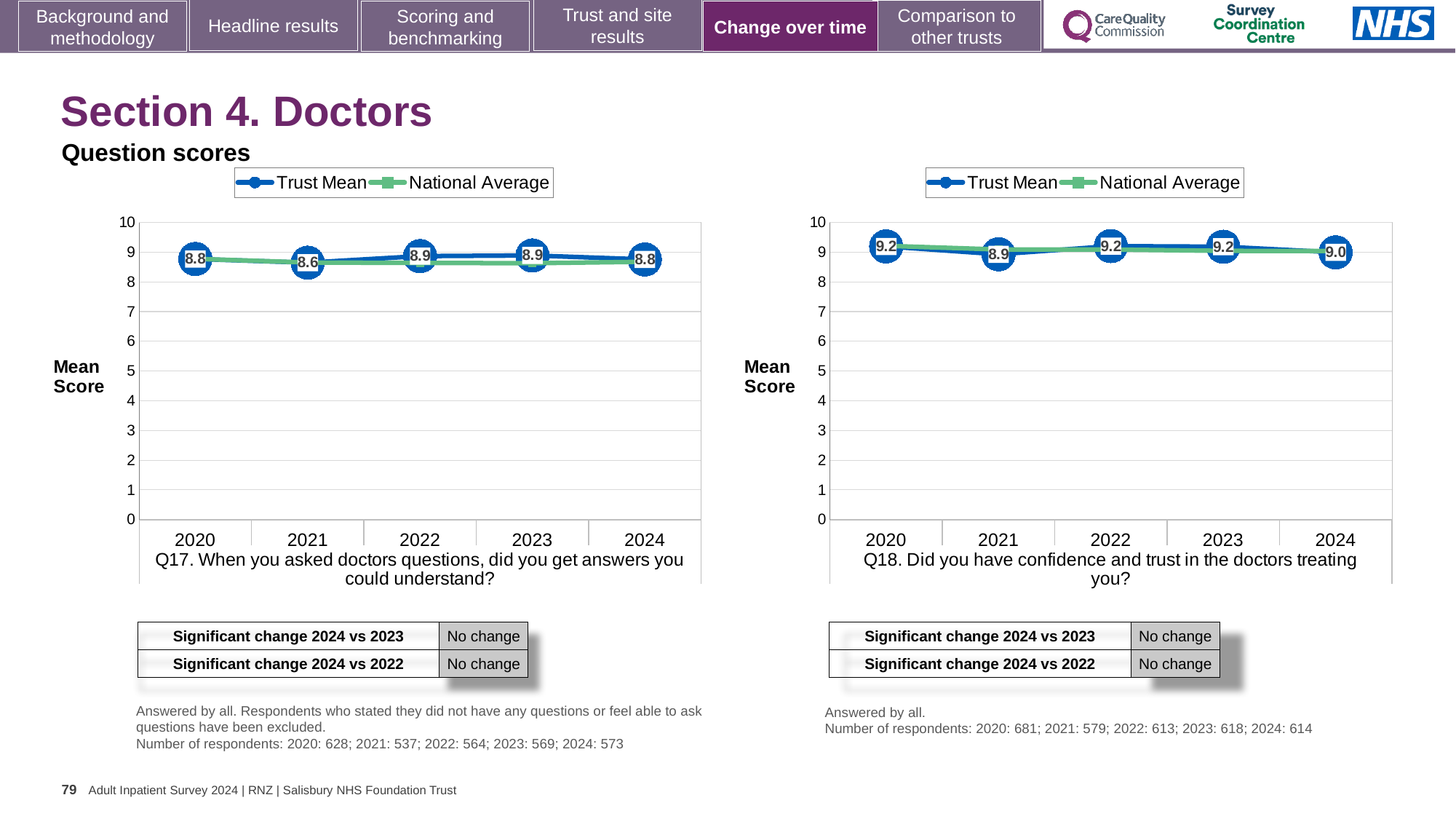
How many years are plotted on the x axis of the Q18 chart (right)? 5 In the Q17 chart (left), what is the difference between the Trust Mean scores for 2022 and 2021? 0.3 In the Q17 chart (left), what is the Trust Mean score for 2021? 8.6 In the Q17 chart (left), is the National Average value for 2024 greater or less than 8? greater In the Q18 chart (right), what is the Trust Mean score for 2024? 9.0 How many series does the legend of the Q17 chart (left) list? 2 In the Q17 chart (left), which year has the lowest Trust Mean score? 2021 In the Q18 chart (right), which year has the lowest Trust Mean score? 2021 In the Q18 chart (right), what is the difference between the Trust Mean scores for 2020 and 2021? 0.3 In the Q18 chart (right), does the Trust Mean score rise or fall from 2023 to 2024? Fall What kind of chart is the Q17 chart (left)? Line chart In the Q18 chart (right), which year has the larger Trust Mean score, 2021 or 2024? 2024